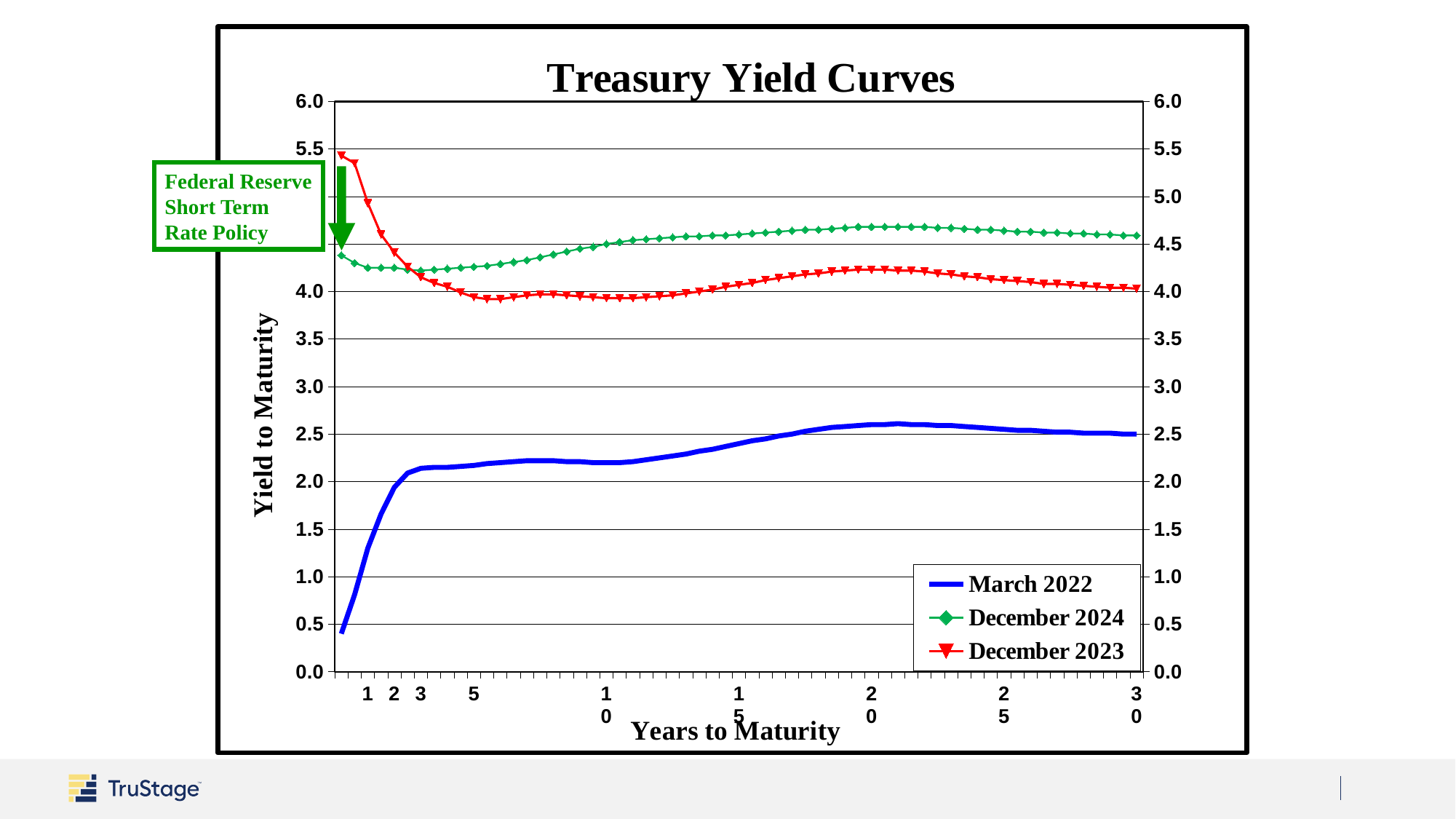
At 30 years to maturity, which series is higher: December 2024 or December 2023? December 2024 Is the December 2023 yield at 5 years to maturity greater or less than 4.5? less Does the March 2022 yield rise or fall between 1 and 5 years to maturity? rise What is the title of the chart? Treasury Yield Curves Which series has the lowest yields across all maturities? March 2022 Is the March 2022 yield at 20 years to maturity greater or less than 2.0? greater Is the December 2023 yield at the shortest maturity greater or less than 5.0? greater What is the label of the x axis? Years to Maturity At 1 year to maturity, which series is higher: December 2023 or December 2024? December 2023 How many series does the legend list? 3 What kind of chart is shown on the slide? Line chart Does the December 2023 yield rise or fall between 1 and 5 years to maturity? fall